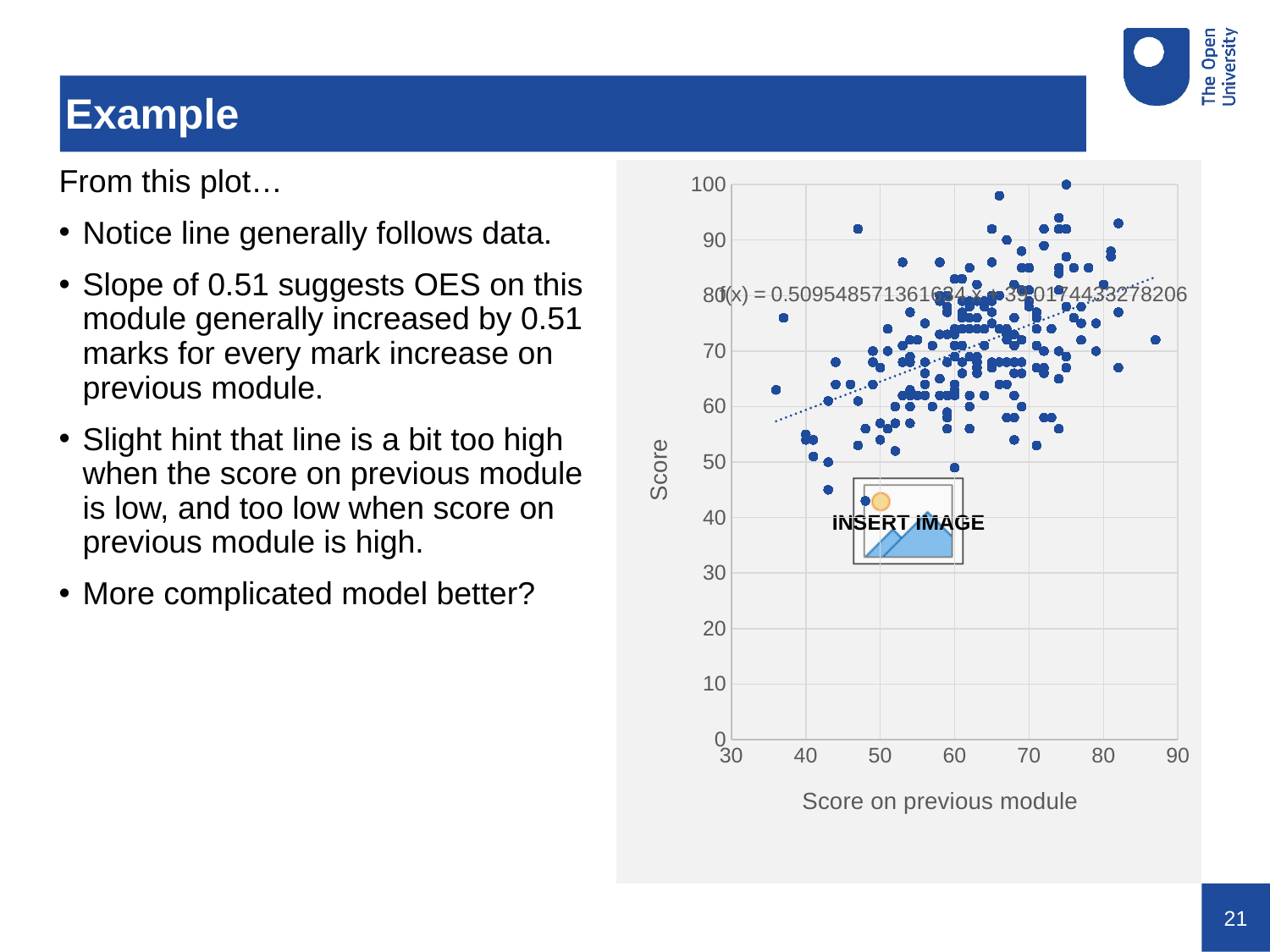
What is the title of the y axis of the chart? Score Is the highest plotted Score value greater or less than 90? greater Is the Score of the point with the largest Score on previous module greater or less than 60? greater At a Score on previous module of 30, is the fitted line's Score greater or less than 60? less What kind of chart is shown on the slide? scatter plot What is the title of the x axis of the chart? Score on previous module Do the plotted Score values generally rise or fall as Score on previous module increases? rise Does the dotted fitted line slope upward or downward from left to right? upward